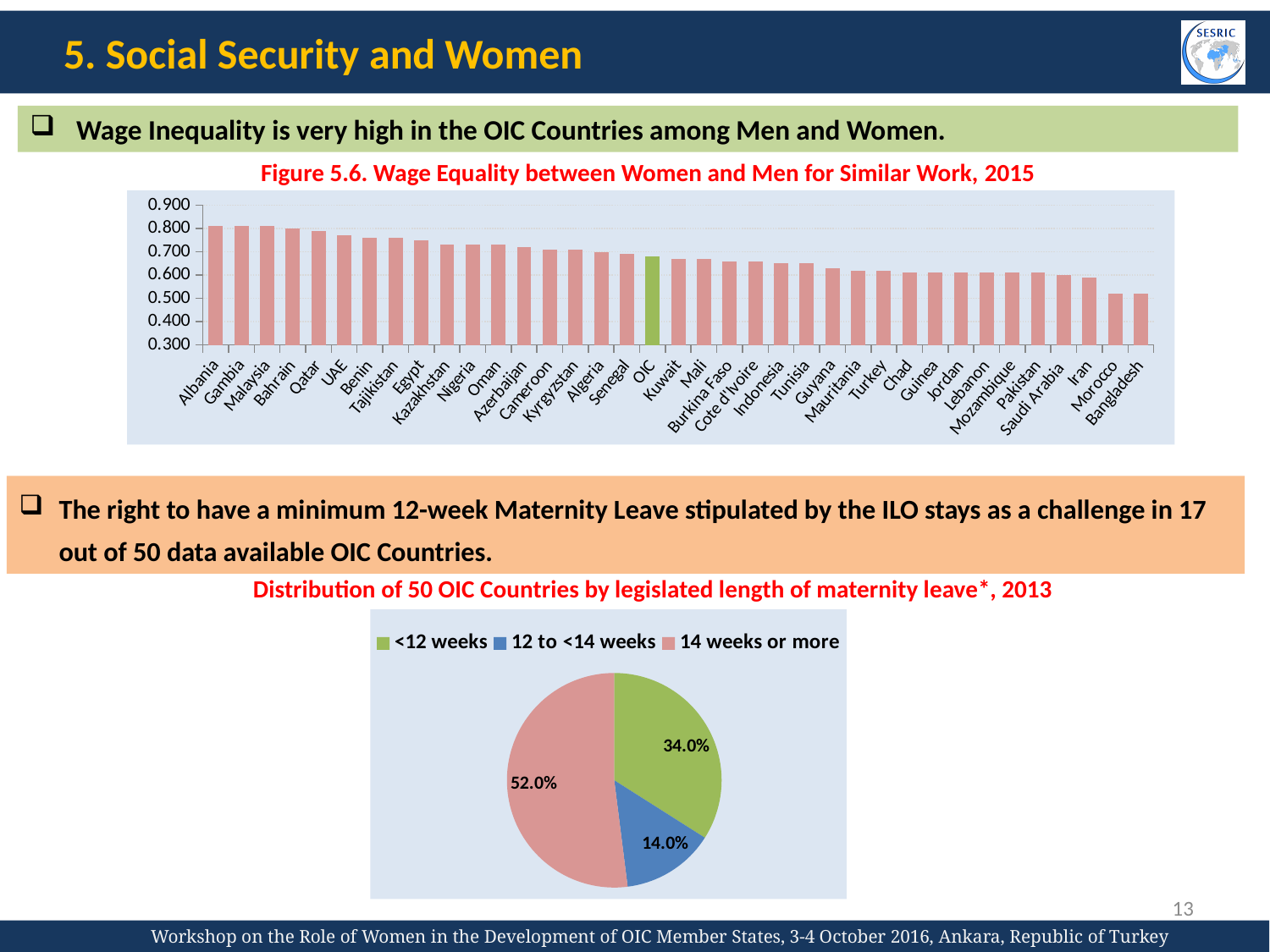
In the pie chart 'Distribution of 50 OIC Countries by legislated length of maternity leave*, 2013', what share of countries have maternity leave of less than 12 weeks? 34.0% In 'Figure 5.6. Wage Equality between Women and Men for Similar Work, 2015', do the values rise or fall moving from left to right along the x axis? Fall In the pie chart 'Distribution of 50 OIC Countries by legislated length of maternity leave*, 2013', what share of countries have maternity leave of 12 to less than 14 weeks? 14.0% What kind of chart is 'Figure 5.6. Wage Equality between Women and Men for Similar Work, 2015'? Bar chart In the pie chart 'Distribution of 50 OIC Countries by legislated length of maternity leave*, 2013', which category has the smallest share? 12 to <14 weeks In 'Figure 5.6. Wage Equality between Women and Men for Similar Work, 2015', is the value for Bangladesh greater or less than 0.600? less In the pie chart 'Distribution of 50 OIC Countries by legislated length of maternity leave*, 2013', how many percentage points larger is the '14 weeks or more' share than the '<12 weeks' share? 18.0 percentage points In 'Figure 5.6. Wage Equality between Women and Men for Similar Work, 2015', is the value for Albania greater or less than 0.700? greater In the pie chart 'Distribution of 50 OIC Countries by legislated length of maternity leave*, 2013', which category has the largest share? 14 weeks or more How many categories does the legend of the pie chart 'Distribution of 50 OIC Countries by legislated length of maternity leave*, 2013' list? 3 In 'Figure 5.6. Wage Equality between Women and Men for Similar Work, 2015', which bar is shown in a different colour (green) from the others? OIC In the pie chart 'Distribution of 50 OIC Countries by legislated length of maternity leave*, 2013', what share of countries have maternity leave of 14 weeks or more? 52.0%